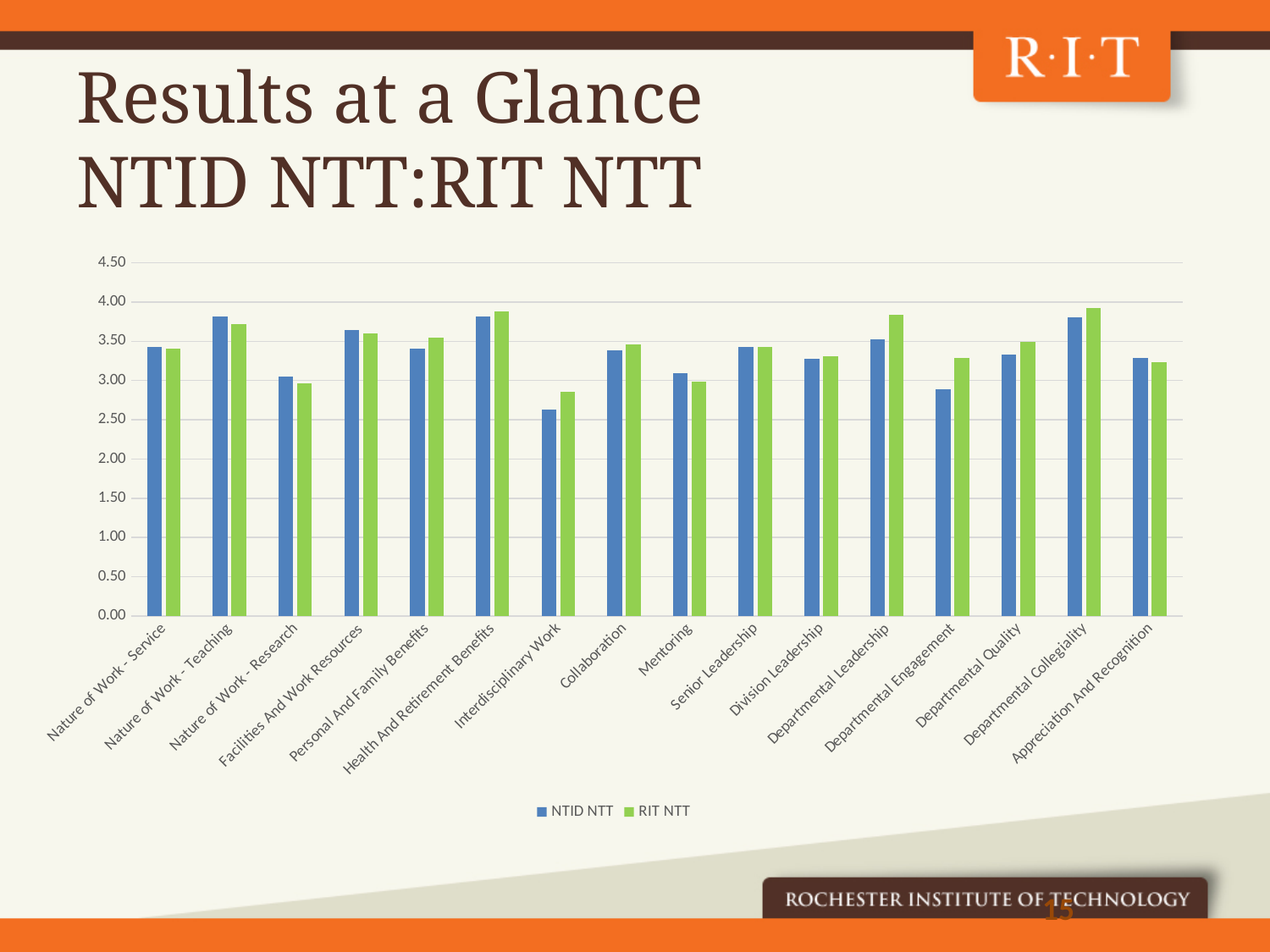
How many categories are shown on the x axis? 16 Which series is shown in green in the legend? RIT NTT For Departmental Leadership, which series has the larger value, NTID NTT or RIT NTT? RIT NTT Is the NTID NTT value for Departmental Engagement greater or less than 3.00? less Is the NTID NTT value for Nature of Work - Teaching greater or less than 3.50? greater Is the NTID NTT value for Interdisciplinary Work greater or less than 3.00? less How many series does the legend list? 2 For Departmental Engagement, which series has the larger value, NTID NTT or RIT NTT? RIT NTT What kind of chart is shown on the slide? bar chart Which category has the lowest NTID NTT value? Interdisciplinary Work What is the highest value labelled on the vertical axis? 4.50